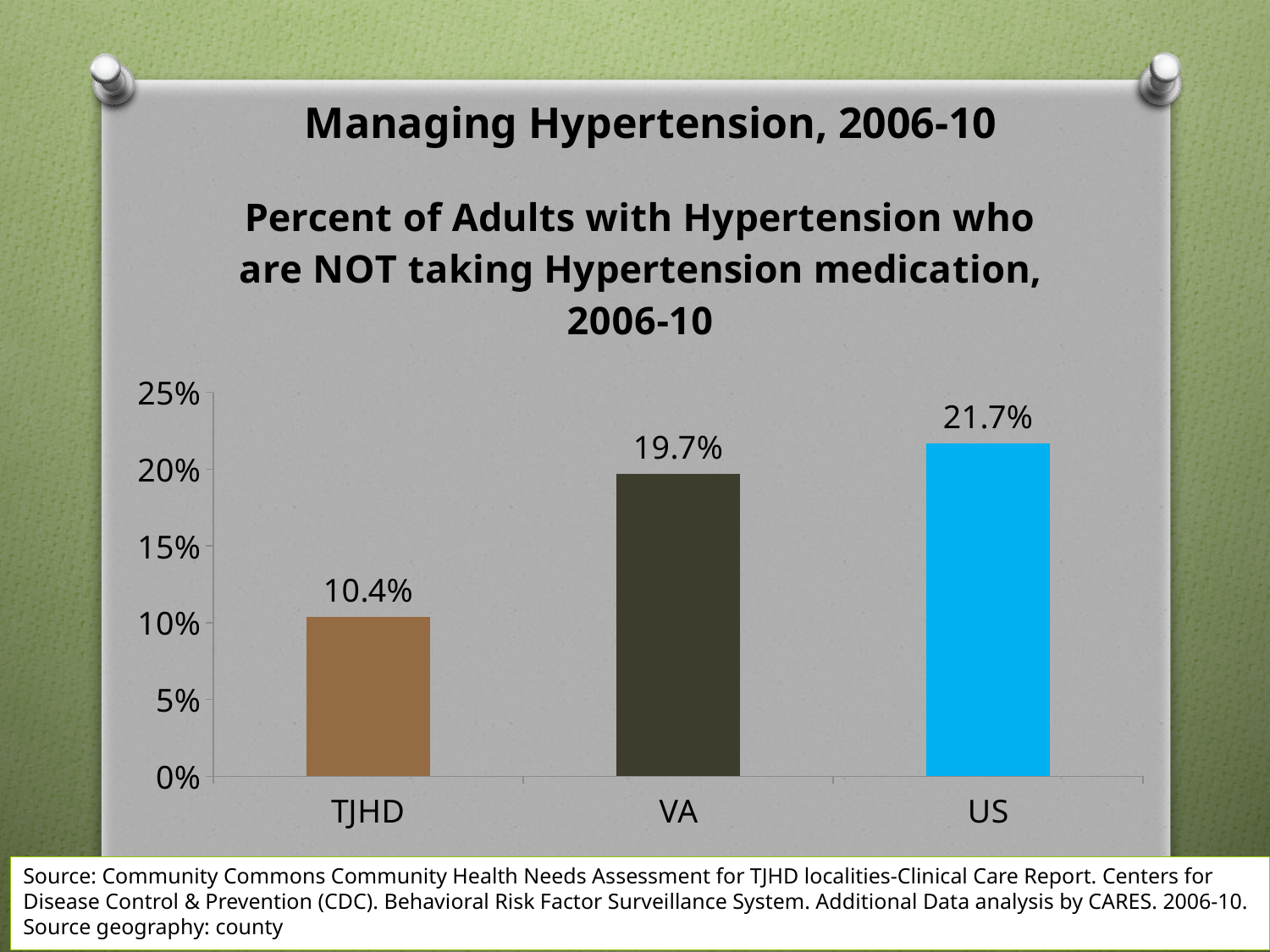
What is the difference between the US value and the TJHD value? 11.3% What is the value for TJHD? 10.4% What is the value for US? 21.7% Which category has the highest value? US What kind of chart is shown on the slide? bar chart Which category has the lowest value? TJHD Is the value for VA greater or less than 15%? greater What is the difference between the US value and the VA value? 2.0% Which is larger, the value for VA or the value for TJHD? VA What is the value for VA? 19.7% How many categories are shown on the x axis? 3 What is the title of the chart? Percent of Adults with Hypertension who are NOT taking Hypertension medication, 2006-10